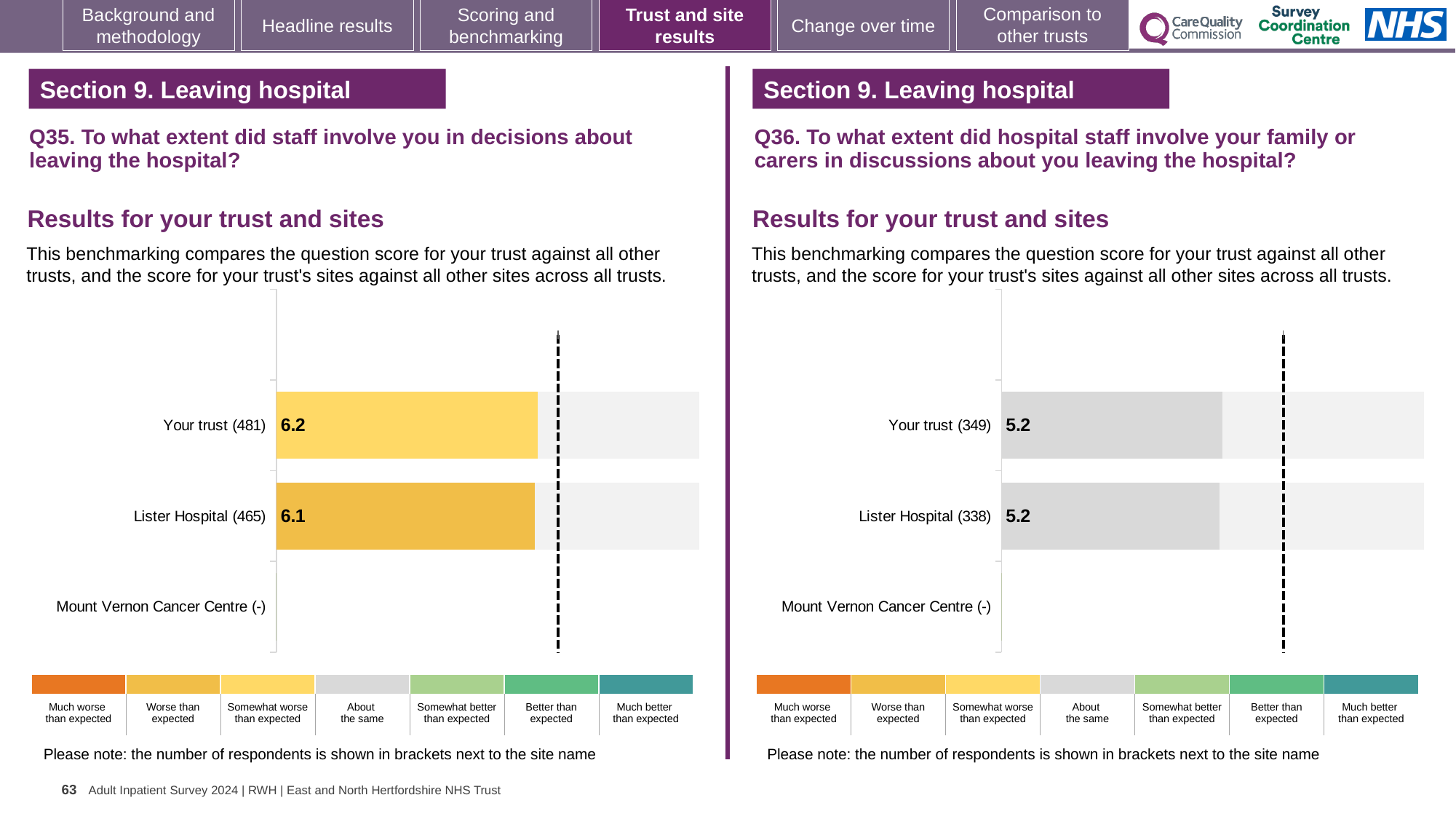
On the Q36 chart (right), how many respondents are shown in brackets for Lister Hospital? 338 On the Q35 chart (left), what is the difference between the scores for Your trust and Lister Hospital? 0.1 On the Q36 chart (right), which benchmark category does the colour of the Lister Hospital bar correspond to? About the same How many categories are listed on the Q35 chart (left)? 3 On the Q36 chart (right), what is the score for Your trust? 5.2 On the Q35 chart (left), what is the score for Your trust? 6.2 On the Q36 chart (right), what is the score for Lister Hospital? 5.2 On the Q35 chart (left), which benchmark category does the colour of the Your trust bar correspond to? Somewhat worse than expected On the Q35 chart (left), what is the score for Lister Hospital? 6.1 What kind of chart is the Q36 chart (right)? Bar chart On the Q35 chart (left), how many respondents are shown in brackets for Your trust? 481 On the Q36 chart (right), what is the difference between the scores for Your trust and Lister Hospital? 0